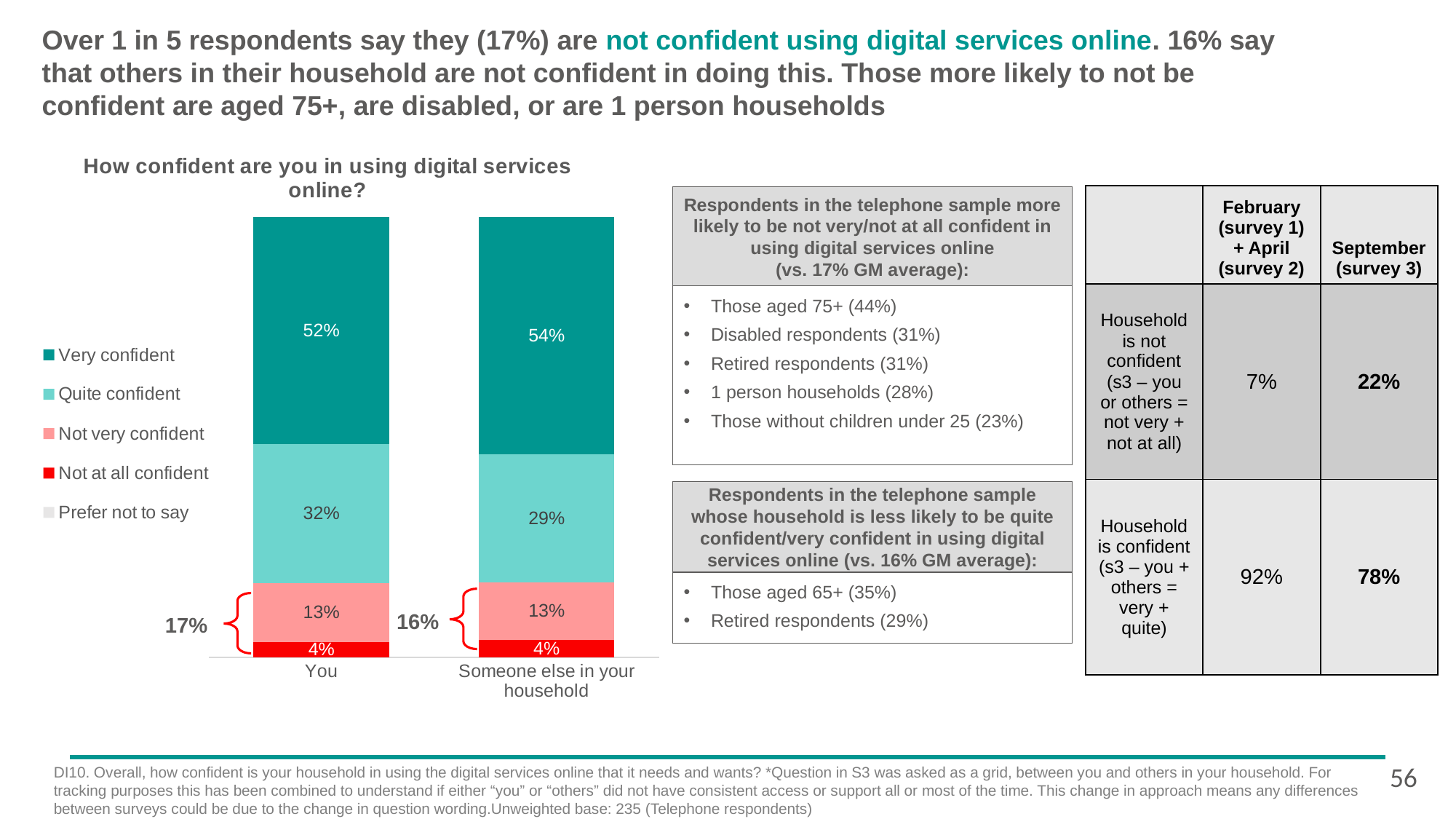
What is the 'Not at all confident' value for 'You'? 4% What is the combined 'Not very confident' plus 'Not at all confident' total shown by the bracket for 'You'? 17% What type of chart is shown on the slide? Stacked bar chart Which category has the higher 'Quite confident' value, 'You' or 'Someone else in your household'? You What is the title of the chart? How confident are you in using digital services online? What is the 'Very confident' value for 'Someone else in your household'? 54% What is the 'Very confident' value for 'You'? 52% How many categories are shown on the x axis of the chart? 2 What is the difference between the 'Quite confident' values for 'You' and 'Someone else in your household'? 3% What is the 'Quite confident' value for 'Someone else in your household'? 29% Which series in the chart is shown in red? Not at all confident How many series does the chart's legend list? 5